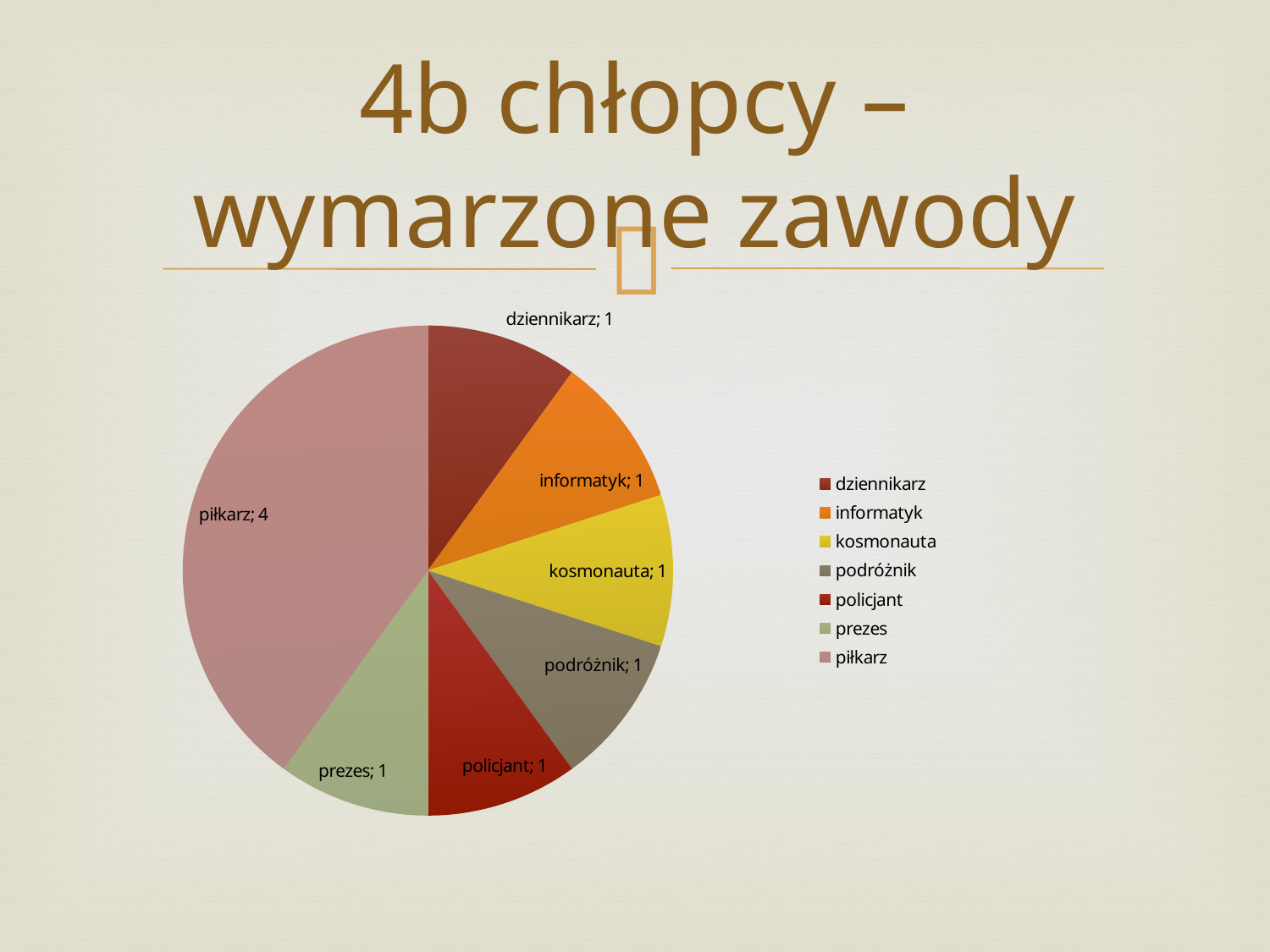
What is the difference between the values for piłkarz and policjant? 3 What is the value for podróżnik? 1 What type of chart is shown on the slide? pie chart Which category has the largest slice of the pie? piłkarz What is the value for kosmonauta? 1 What is the total of all the values in the pie chart? 10 Which is larger, the value for piłkarz or the value for informatyk? piłkarz What share of the pie does dziennikarz represent? 10% How many categories does the pie chart have? 7 What share of the pie does piłkarz represent? 40% What is the title of the slide containing the chart? 4b chłopcy – wymarzone zawody What is the value for piłkarz? 4